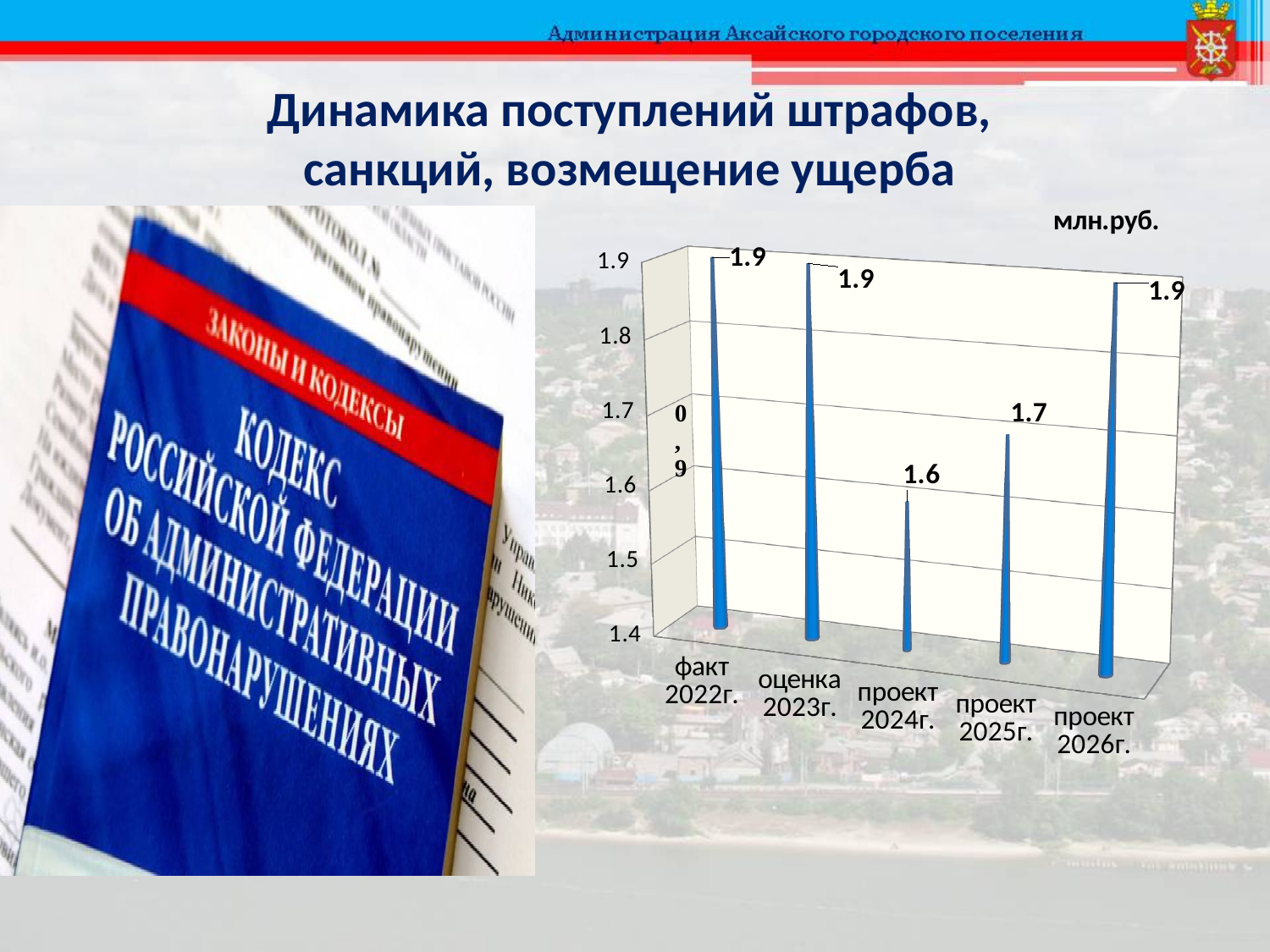
What is the difference between the values for проект 2026г. and проект 2025г.? 0.2 What is the value for проект 2026г.? 1.9 How many categories are shown on the chart? 5 What is the value for проект 2024г.? 1.6 Which is larger, the value for проект 2025г. or the value for проект 2024г.? проект 2025г. Is the value for проект 2024г. greater or less than 1.7? less What unit is indicated above the chart? млн.руб. What is the value for проект 2025г.? 1.7 What is the value for факт 2022г.? 1.9 What kind of chart is shown on the slide? bar chart Which category has the lowest value? проект 2024г. What is the difference between the values for оценка 2023г. and проект 2024г.? 0.3